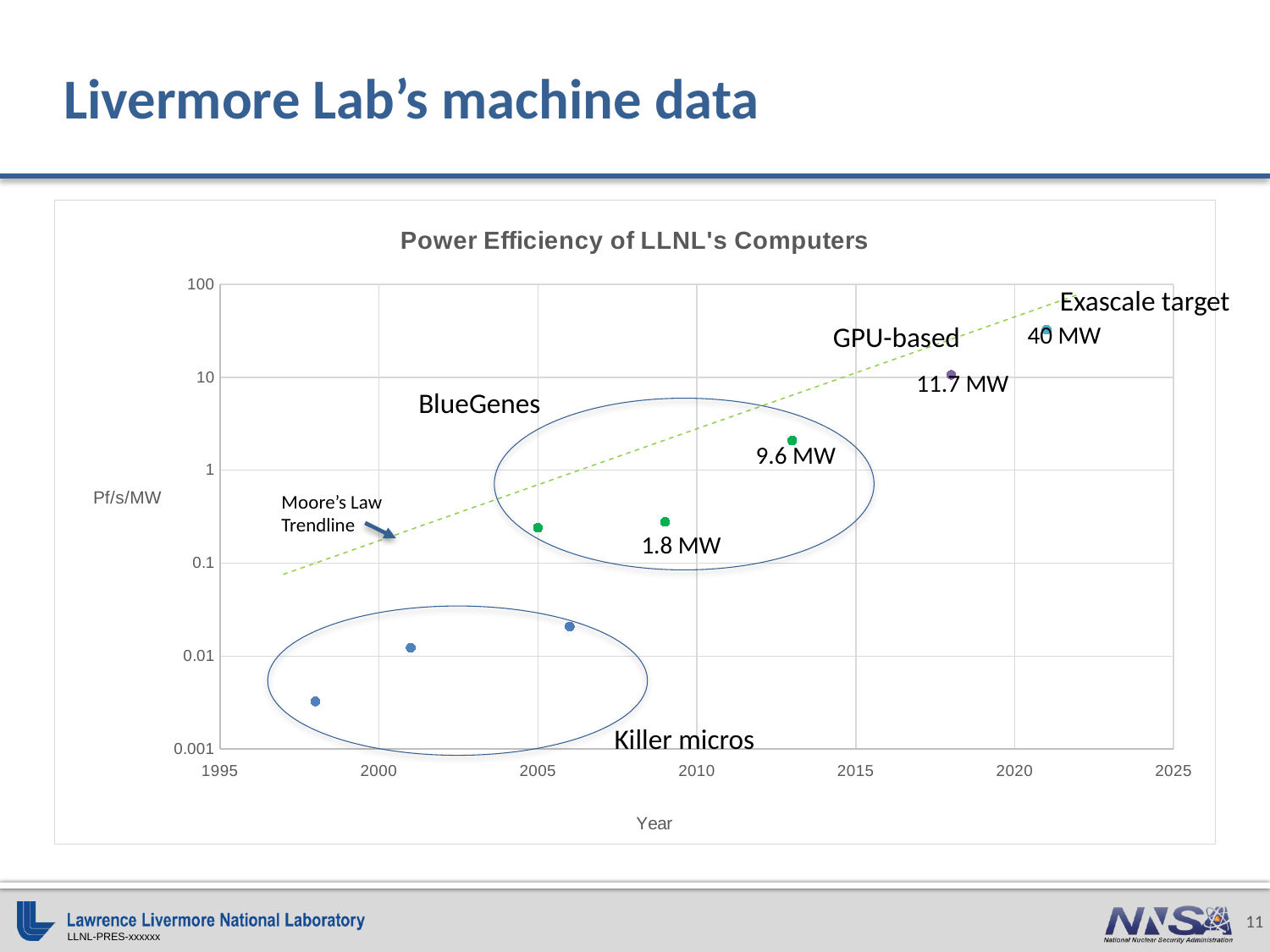
What is the label on the vertical axis of the chart? Pf/s/MW What power figure is labelled next to the GPU-based point? 11.7 MW Is the value for the BlueGene point labelled 9.6 MW greater or less than 1 Pf/s/MW? greater What power figure is labelled next to the Exascale target point? 40 MW How many data points are plotted in the chart? 8 Is the value for the BlueGene point labelled 1.8 MW greater or less than 1 Pf/s/MW? less How many data points are circled in the Killer micros group? 3 Is the value for the Exascale target point greater or less than 10 Pf/s/MW? greater What kind of chart is shown on the slide? scatter chart What is the title of the chart? Power Efficiency of LLNL's Computers Do the plotted power efficiency values rise or fall as the year increases? rise